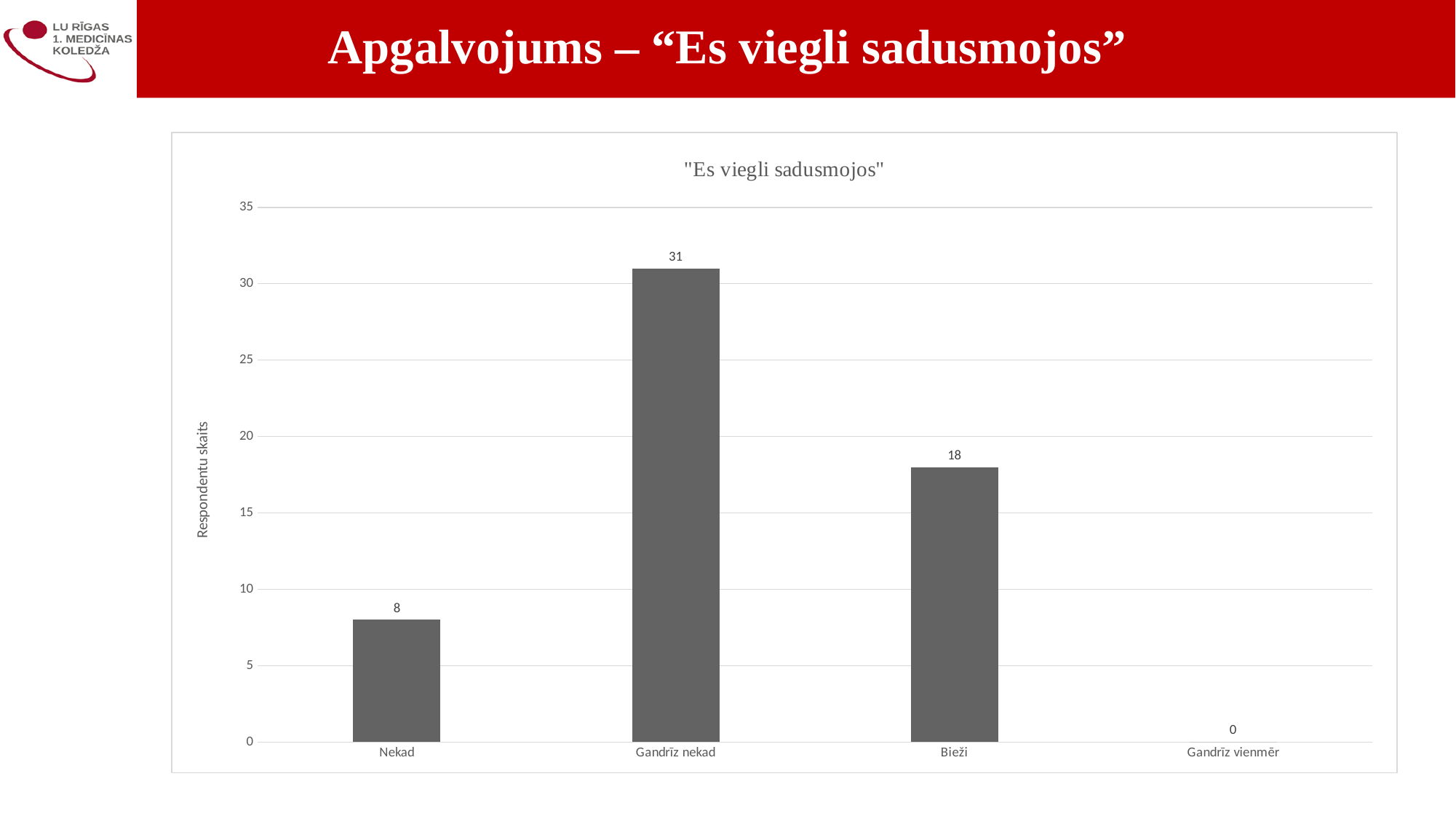
What is the value for Nekad? 8 What is the difference between the values for Gandrīz nekad and Bieži? 13 Is the value for Gandrīz nekad greater or less than 30? greater Which is larger, the value for Nekad or the value for Bieži? Bieži Which category has the lowest value? Gandrīz vienmēr How many categories are shown on the x axis? 4 What is the value for Bieži? 18 Which category has the highest value? Gandrīz nekad What is the label of the vertical axis? Respondentu skaits What is the value for Gandrīz nekad? 31 What is the value for Gandrīz vienmēr? 0 What kind of chart is shown on the slide? bar chart